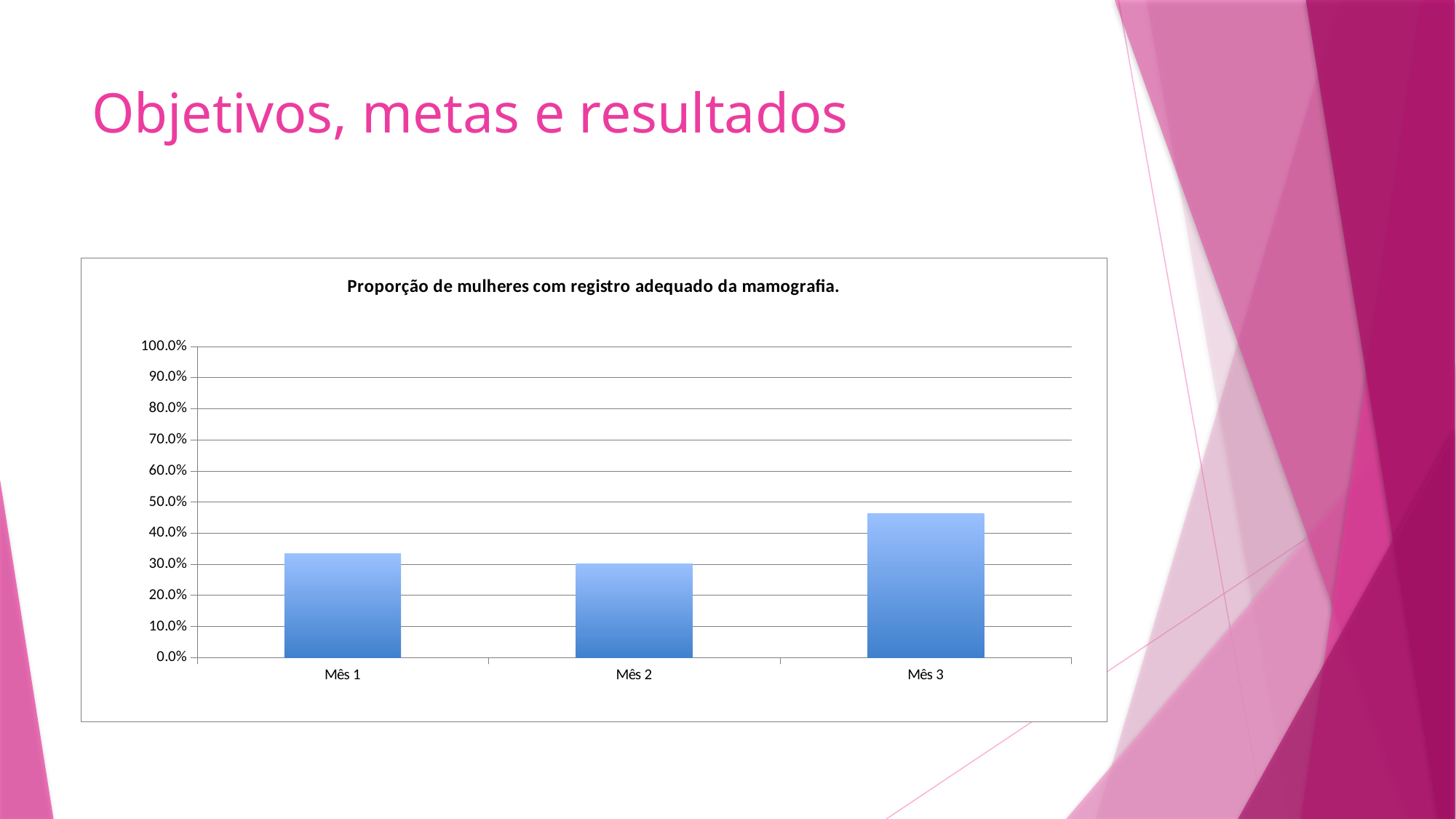
Is the value for Mês 1 greater or less than 40.0%? less What kind of chart is shown on the slide? bar chart Which month has the highest value in the chart? Mês 3 Is the value for Mês 2 greater or less than 40.0%? less Which is larger, the value for Mês 3 or the value for Mês 2? Mês 3 Is the value for Mês 3 greater or less than 40.0%? greater What is the title of the chart? Proporção de mulheres com registro adequado da mamografia. Which month has the lowest value in the chart? Mês 2 How many categories are shown on the x axis of the chart? 3 What is the highest value shown on the y axis of the chart? 100.0%